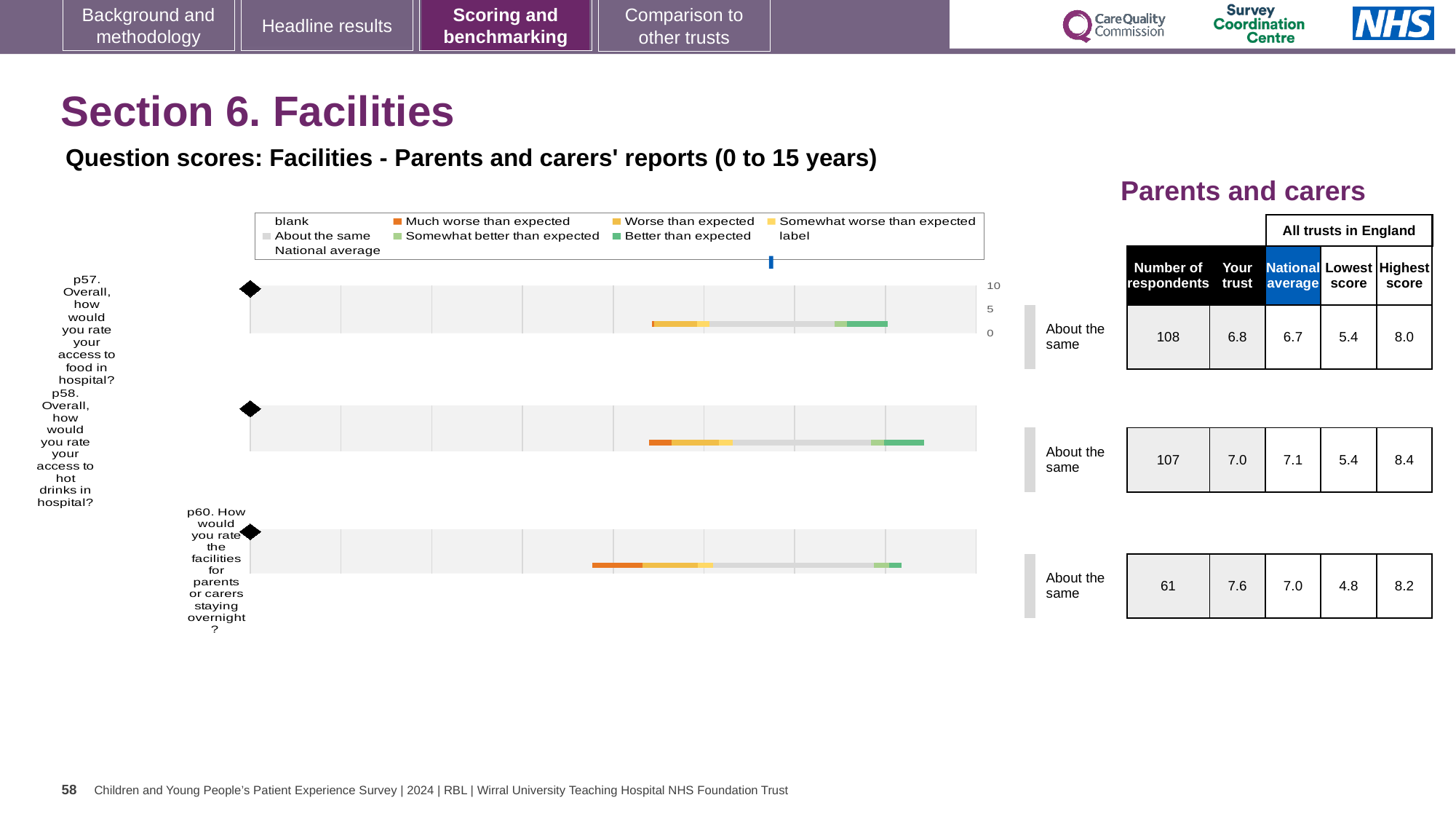
What is the subtitle describing the question scores shown in the chart? Question scores: Facilities - Parents and carers' reports (0 to 15 years) What benchmark category is shown for all three questions in the chart? About the same What is the highest score across all trusts in England for p58? 8.4 For p58, which is larger: the 'Your trust' score or the national average? National average What kind of chart is used to show the question scores on this slide? bar chart What is the 'Your trust' score for p57 (access to food in hospital)? 6.8 How many questions (categories) are plotted in the chart? 3 Which question has the lowest 'Lowest score' among all trusts in England? p60. How would you rate the facilities for parents or carers staying overnight? What is the national average score for p58 (access to hot drinks in hospital)? 7.1 Which question has the highest 'Your trust' score? p60. How would you rate the facilities for parents or carers staying overnight? How many respondents answered p60 (facilities for parents or carers staying overnight)? 61 What is the difference between the highest score and the lowest score for p57? 2.6